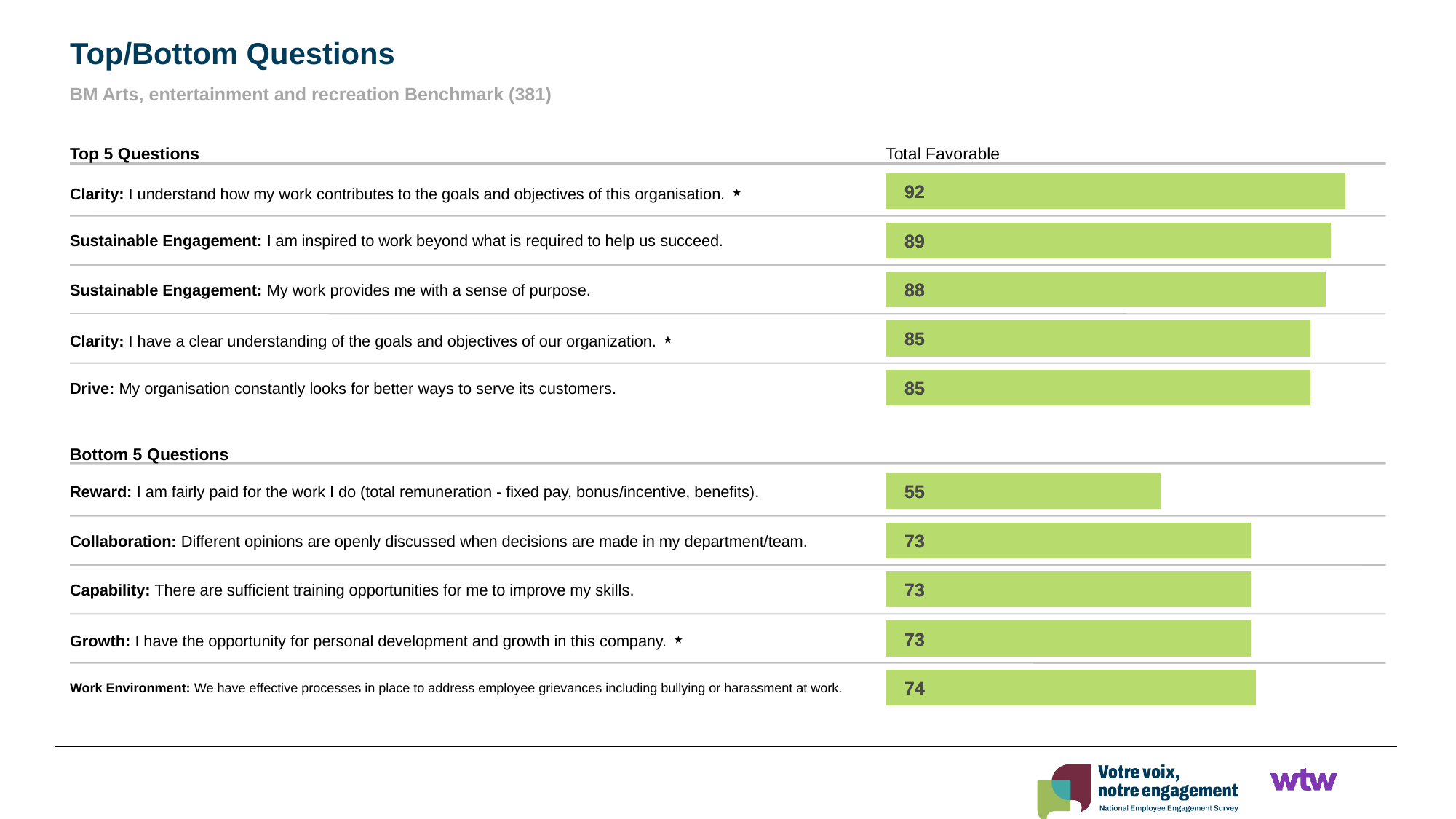
What is the subtitle shown under the slide title "Top/Bottom Questions"? BM Arts, entertainment and recreation Benchmark (381) In the Top 5 Questions chart, what is the Total Favorable value for "Clarity: I understand how my work contributes to the goals and objectives of this organisation"? 92 In the Top 5 Questions chart, which question has the highest Total Favorable value? Clarity: I understand how my work contributes to the goals and objectives of this organisation. In the Top 5 Questions chart, what is the difference between the Total Favorable values for "Clarity: I understand how my work contributes..." and "Drive: My organisation constantly looks for better ways to serve its customers"? 7 What kind of chart is used to show the Total Favorable values on this slide? Bar chart In the Bottom 5 Questions chart, what is the Total Favorable value for "Reward: I am fairly paid for the work I do"? 55 In the Bottom 5 Questions chart, what is the difference between the Total Favorable values for "Work Environment" and "Reward"? 19 In the Bottom 5 Questions chart, which question has the lowest Total Favorable value? Reward: I am fairly paid for the work I do (total remuneration - fixed pay, bonus/incentive, benefits). In the Bottom 5 Questions chart, what is the Total Favorable value for "Work Environment: We have effective processes in place to address employee grievances"? 74 In the Top 5 Questions chart, which has a larger Total Favorable value: "Sustainable Engagement: I am inspired to work beyond what is required to help us succeed" or "Clarity: I have a clear understanding of the goals and objectives of our organization"? Sustainable Engagement: I am inspired to work beyond what is required to help us succeed. How many questions are shown in the Bottom 5 Questions chart? 5 In the Top 5 Questions chart, what is the Total Favorable value for "Sustainable Engagement: My work provides me with a sense of purpose"? 88